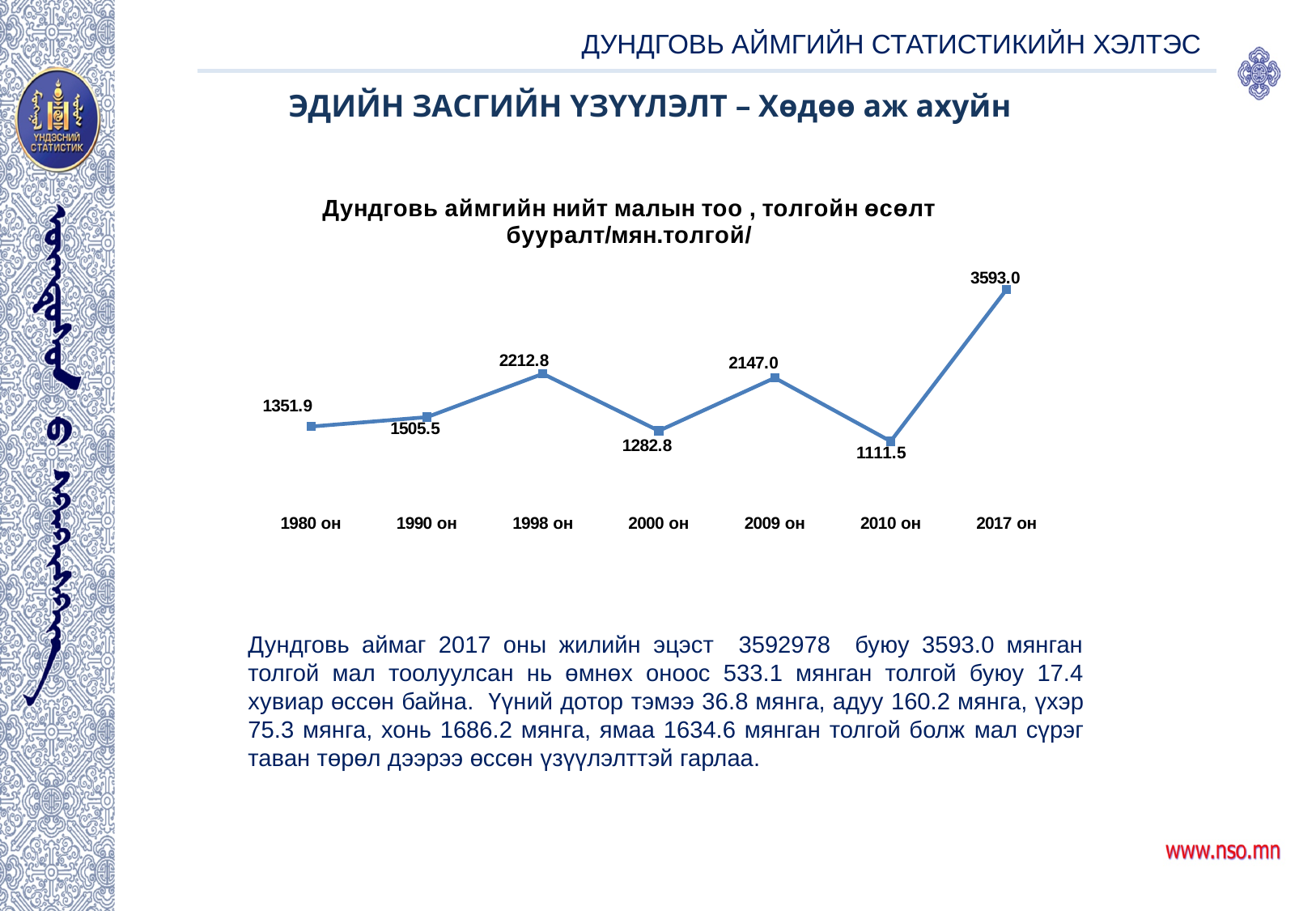
What is the difference between the values for 1998 он and 2009 он? 65.8 Which is larger, the value for 1990 он or the value for 2000 он? 1990 он What is the difference between the values for 2017 он and 2010 он? 2481.5 What is the value for 2010 он? 1111.5 Which year has the highest value? 2017 он Which year has the lowest value? 2010 он What is the value for 2017 он? 3593.0 What is the value for 1998 он? 2212.8 How many years are plotted on the chart? 7 Does the value rise or fall from 2010 он to 2017 он? Rise What kind of chart is shown on the slide? Line chart What is the value for 1980 он? 1351.9